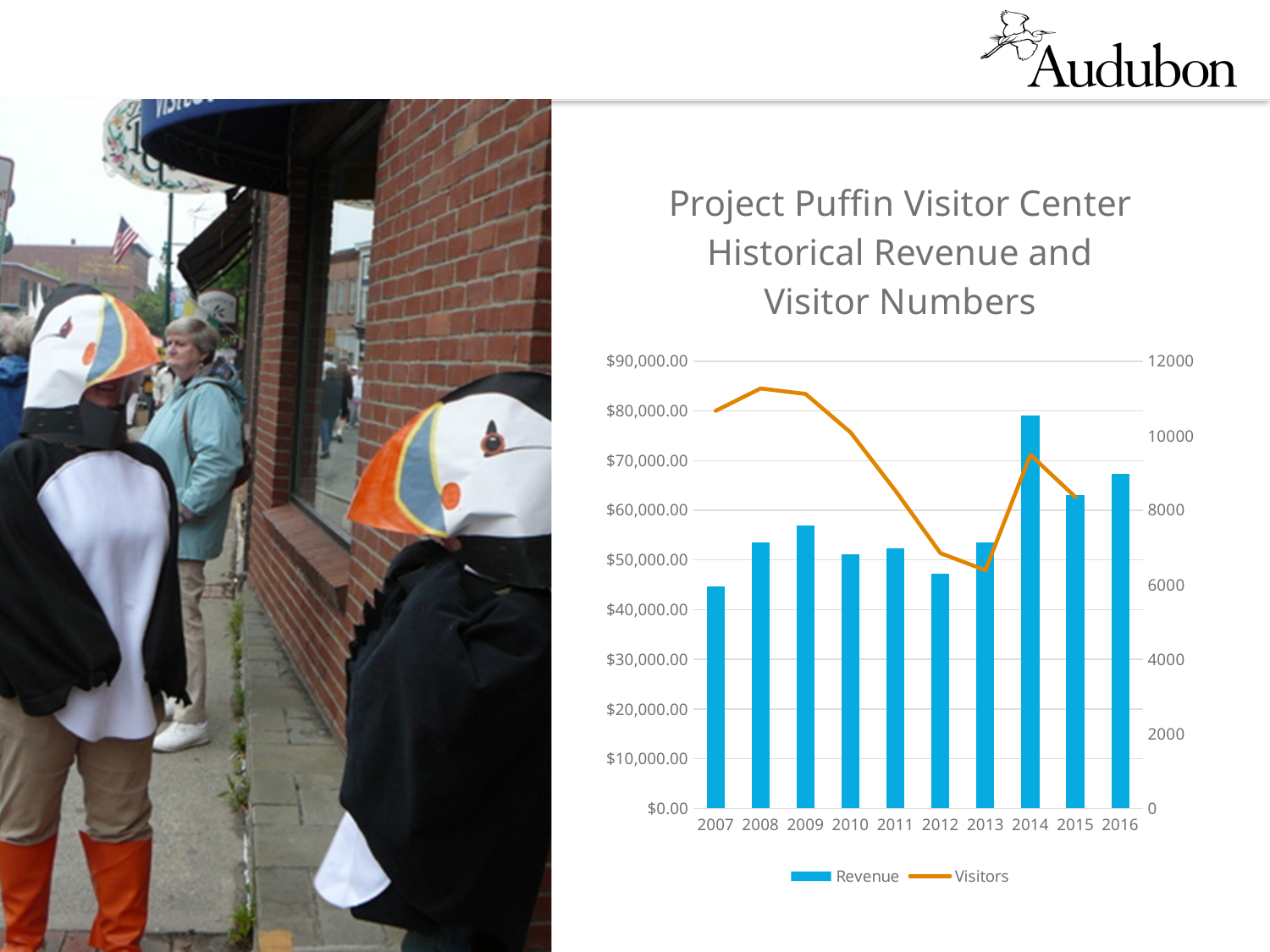
Which series is drawn as a line rather than bars? Visitors Which year has the lowest Revenue bar? 2007 How many years are shown on the x axis? 10 Which year has higher Revenue, 2009 or 2010? 2009 Is the Visitors value for 2013 greater or less than 8000? less What is the title of the chart? Project Puffin Visitor Center Historical Revenue and Visitor Numbers How many series does the legend list? 2 Is the Visitors value for 2008 greater or less than 10000? greater Is the Revenue for 2007 greater or less than $50,000.00? less Do the Visitors values rise or fall from 2009 to 2013? fall Which year has the highest Revenue bar? 2014